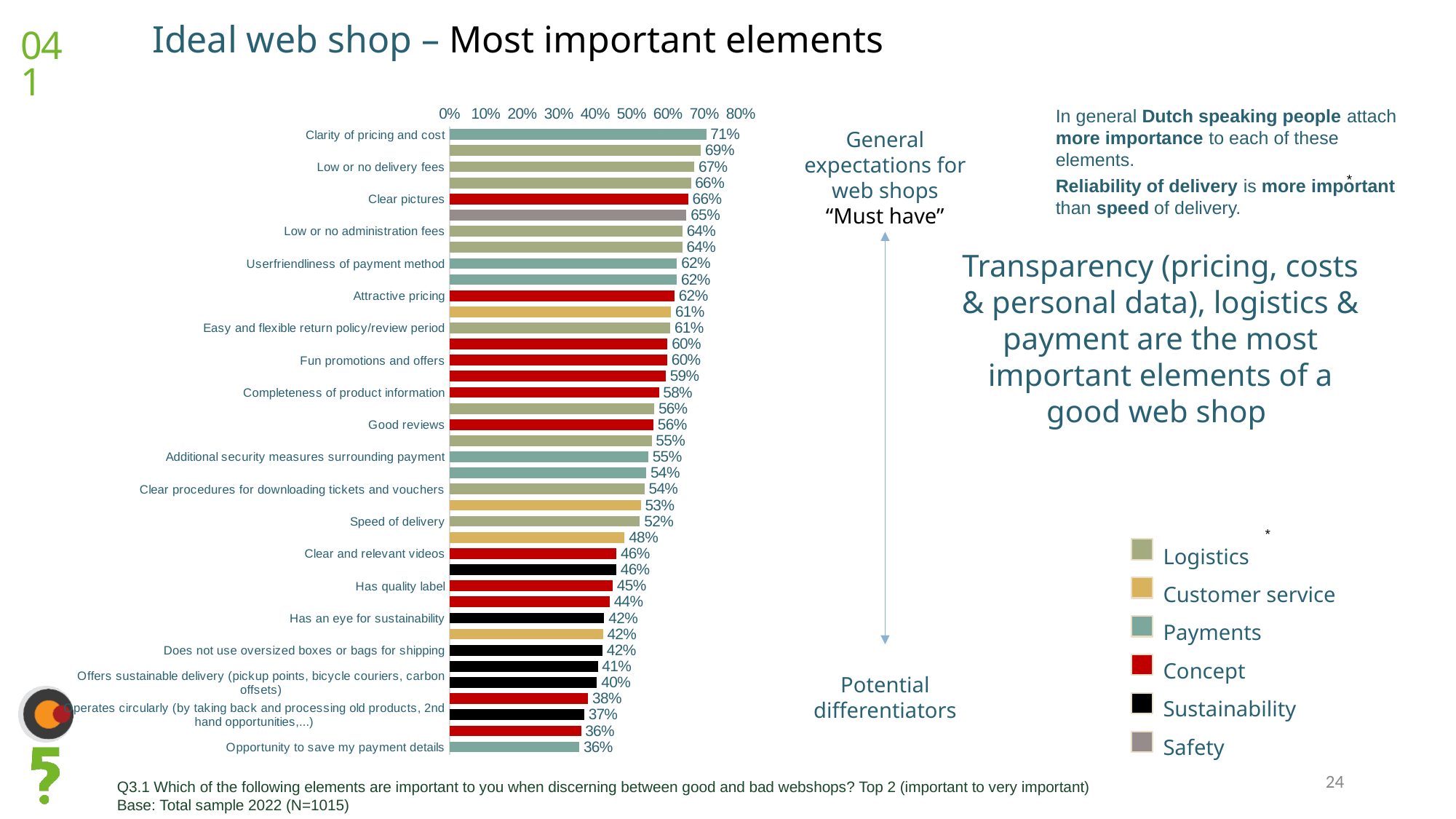
What is the difference between Clarity of pricing and cost and Speed of delivery? 19% What is the value for Good reviews? 56% What is the difference between Low or no delivery fees and Has quality label? 22% What is the value for Speed of delivery? 52% What is the value for Opportunity to save my payment details? 36% What is the value for Clarity of pricing and cost? 71% Which legend entry is shown in red? Concept Which is larger, Clear pictures or Clear and relevant videos? Clear pictures Is the value for Offers sustainable delivery greater or less than 50%? less What kind of chart is shown on the slide? bar chart How many series does the legend list? 6 Which labelled element has the highest value? Clarity of pricing and cost